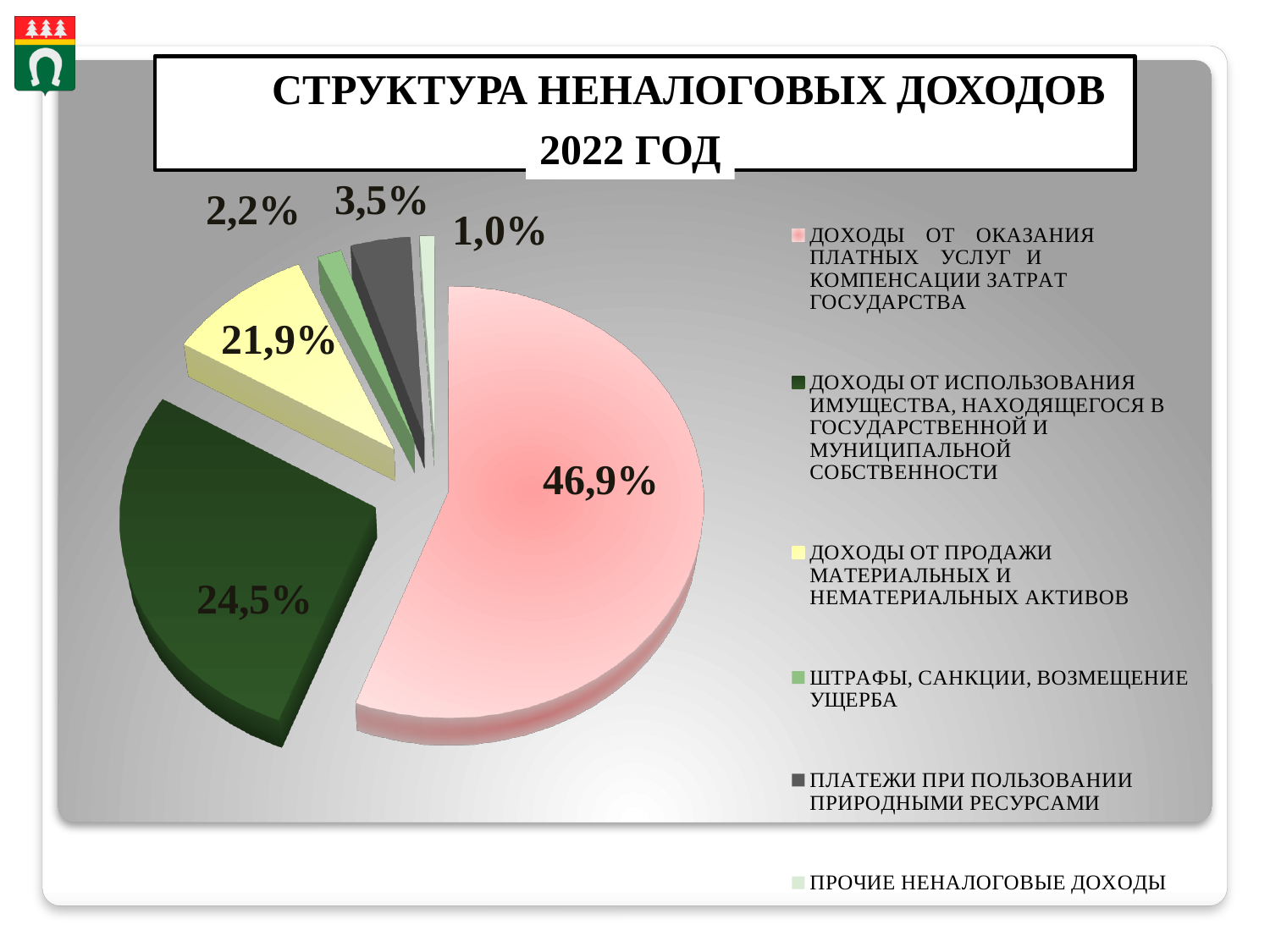
Which category has the largest slice of the pie? ДОХОДЫ ОТ ОКАЗАНИЯ ПЛАТНЫХ УСЛУГ И КОМПЕНСАЦИИ ЗАТРАТ ГОСУДАРСТВА What type of chart is shown on the slide? Pie chart How many categories does the legend list? 6 What share of the pie does ДОХОДЫ ОТ ПРОДАЖИ МАТЕРИАЛЬНЫХ И НЕМАТЕРИАЛЬНЫХ АКТИВОВ have? 21,9% What share of the pie does ПЛАТЕЖИ ПРИ ПОЛЬЗОВАНИИ ПРИРОДНЫМИ РЕСУРСАМИ have? 3,5% Which is larger: the slice for ШТРАФЫ, САНКЦИИ, ВОЗМЕЩЕНИЕ УЩЕРБА or the slice for ПЛАТЕЖИ ПРИ ПОЛЬЗОВАНИИ ПРИРОДНЫМИ РЕСУРСАМИ? ПЛАТЕЖИ ПРИ ПОЛЬЗОВАНИИ ПРИРОДНЫМИ РЕСУРСАМИ What share of the pie does ПРОЧИЕ НЕНАЛОГОВЫЕ ДОХОДЫ have? 1,0% What share of the pie does ДОХОДЫ ОТ ИСПОЛЬЗОВАНИЯ ИМУЩЕСТВА, НАХОДЯЩЕГОСЯ В ГОСУДАРСТВЕННОЙ И МУНИЦИПАЛЬНОЙ СОБСТВЕННОСТИ have? 24,5% What is the difference in percentage points between the slice for ДОХОДЫ ОТ ИСПОЛЬЗОВАНИЯ ИМУЩЕСТВА and the slice for ДОХОДЫ ОТ ПРОДАЖИ МАТЕРИАЛЬНЫХ И НЕМАТЕРИАЛЬНЫХ АКТИВОВ? 2,6 What share of the pie does ШТРАФЫ, САНКЦИИ, ВОЗМЕЩЕНИЕ УЩЕРБА have? 2,2% What share of the pie does ДОХОДЫ ОТ ОКАЗАНИЯ ПЛАТНЫХ УСЛУГ И КОМПЕНСАЦИИ ЗАТРАТ ГОСУДАРСТВА have? 46,9% Which category has the smallest slice of the pie? ПРОЧИЕ НЕНАЛОГОВЫЕ ДОХОДЫ